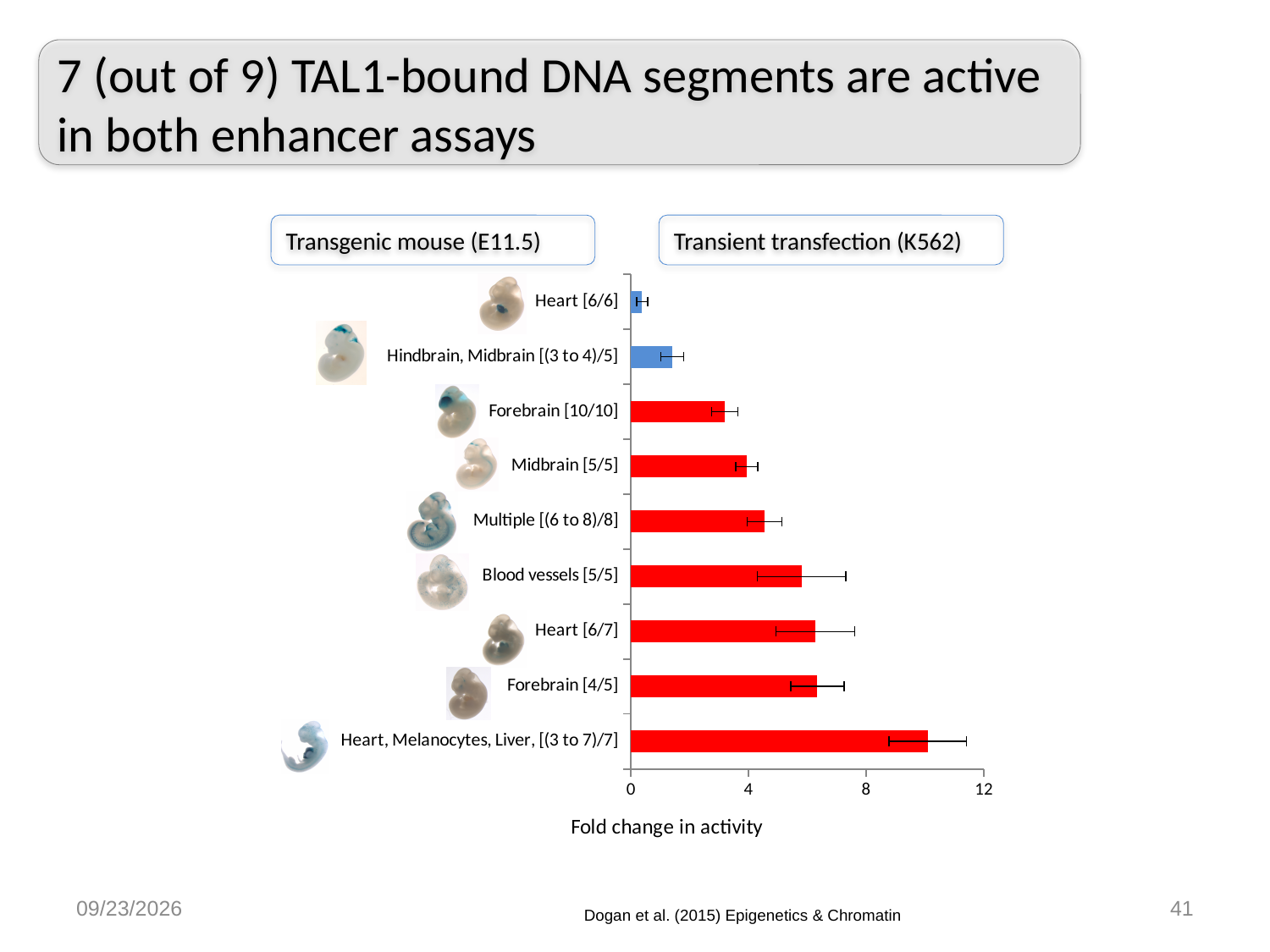
What is the label of the x axis of the chart? Fold change in activity Is the fold change in activity for Hindbrain, Midbrain [(3 to 4)/5] greater or less than 4? less Which category has the highest fold change in activity? Heart, Melanocytes, Liver, [(3 to 7)/7] What kind of chart is shown on the slide? bar chart Is the fold change in activity for Forebrain [10/10] greater or less than 4? less How many bars in the chart are coloured blue rather than red? 2 Is the fold change in activity for Heart, Melanocytes, Liver, [(3 to 7)/7] greater or less than 8? greater How many categories (bars) does the chart show? 9 Which has a larger fold change in activity, Blood vessels [5/5] or Forebrain [10/10]? Blood vessels [5/5] Which has a larger fold change in activity, Heart [6/6] or Hindbrain, Midbrain [(3 to 4)/5]? Hindbrain, Midbrain [(3 to 4)/5] Which category has the lowest fold change in activity? Heart [6/6]